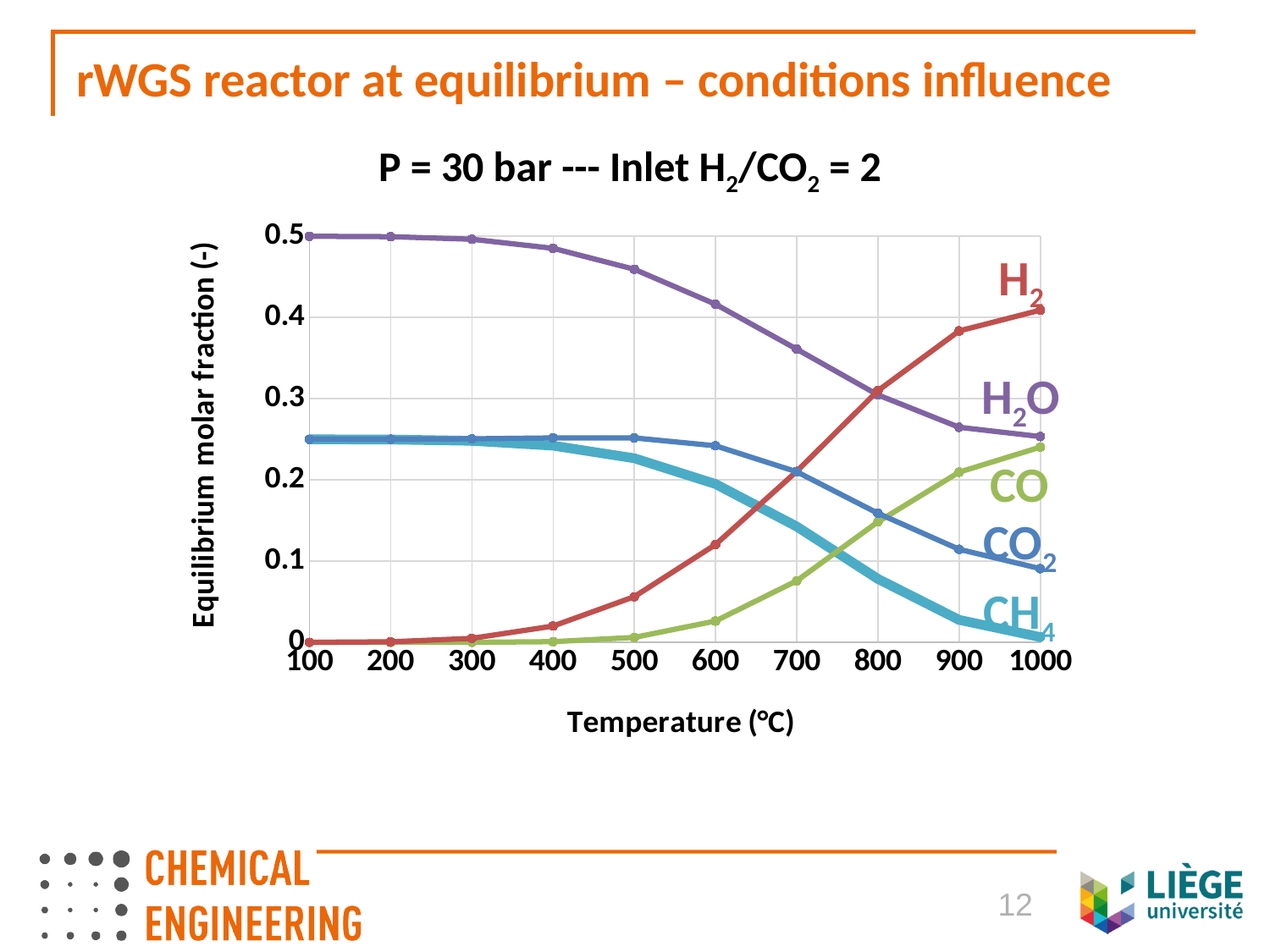
Which series has the lowest molar fraction at 1000 °C? CH4 Does the H2O molar fraction rise or fall as temperature increases from 100 to 1000 °C? fall Is the CO molar fraction at 700 °C greater or less than 0.1? less Does the CH4 molar fraction rise or fall as temperature increases from 500 to 1000 °C? fall How many series are labelled on the chart? 5 Is the H2O molar fraction at 700 °C greater or less than 0.3? greater What kind of chart is shown on the slide? line chart How many temperature points are plotted along the x axis? 10 Which series has the highest molar fraction at 1000 °C? H2 At 100 °C, which is larger, the H2O molar fraction or the CO2 molar fraction? H2O Does the H2 molar fraction rise or fall as temperature increases from 100 to 1000 °C? rise What is the label of the y axis? Equilibrium molar fraction (-)